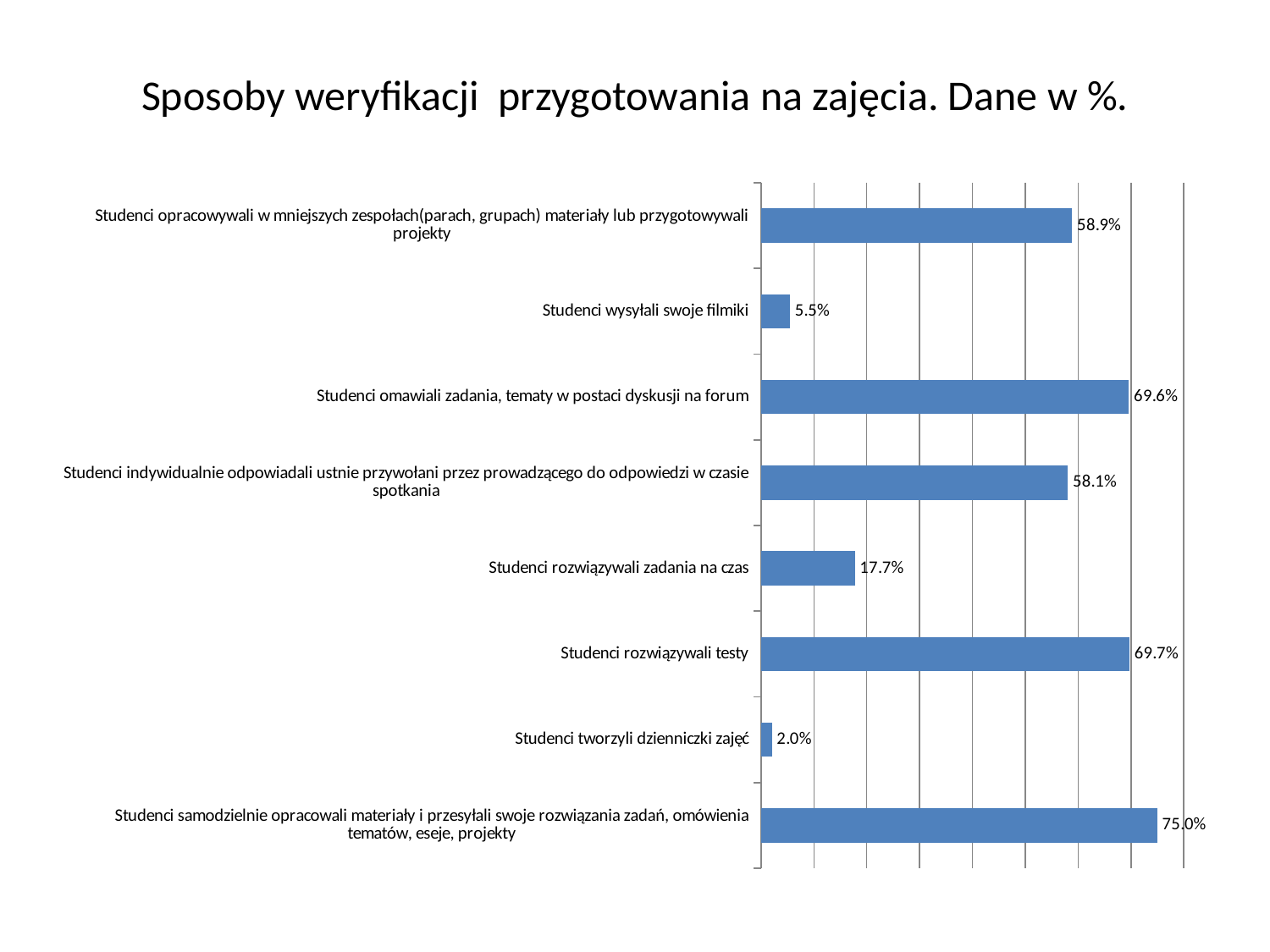
What is the value for "Studenci wysyłali swoje filmiki"? 5.5% Which category has the lowest value? Studenci tworzyli dzienniczki zajęć What is the difference between the value for "Studenci samodzielnie opracowali materiały i przesyłali swoje rozwiązania zadań, omówienia tematów, eseje, projekty" and the value for "Studenci opracowywali w mniejszych zespołach(parach, grupach) materiały lub przygotowywali projekty"? 16.1 percentage points What is the difference between the value for "Studenci rozwiązywali zadania na czas" and the value for "Studenci wysyłali swoje filmiki"? 12.2 percentage points Which category has the highest value? Studenci samodzielnie opracowali materiały i przesyłali swoje rozwiązania zadań, omówienia tematów, eseje, projekty How many categories are shown in the chart? 8 What is the value for "Studenci rozwiązywali zadania na czas"? 17.7% What kind of chart is shown on the slide? Bar chart What is the value for "Studenci tworzyli dzienniczki zajęć"? 2.0% What is the value for "Studenci rozwiązywali testy"? 69.7% Which is larger: the value for "Studenci rozwiązywali testy" or the value for "Studenci rozwiązywali zadania na czas"? Studenci rozwiązywali testy What is the value for "Studenci omawiali zadania, tematy w postaci dyskusji na forum"? 69.6%